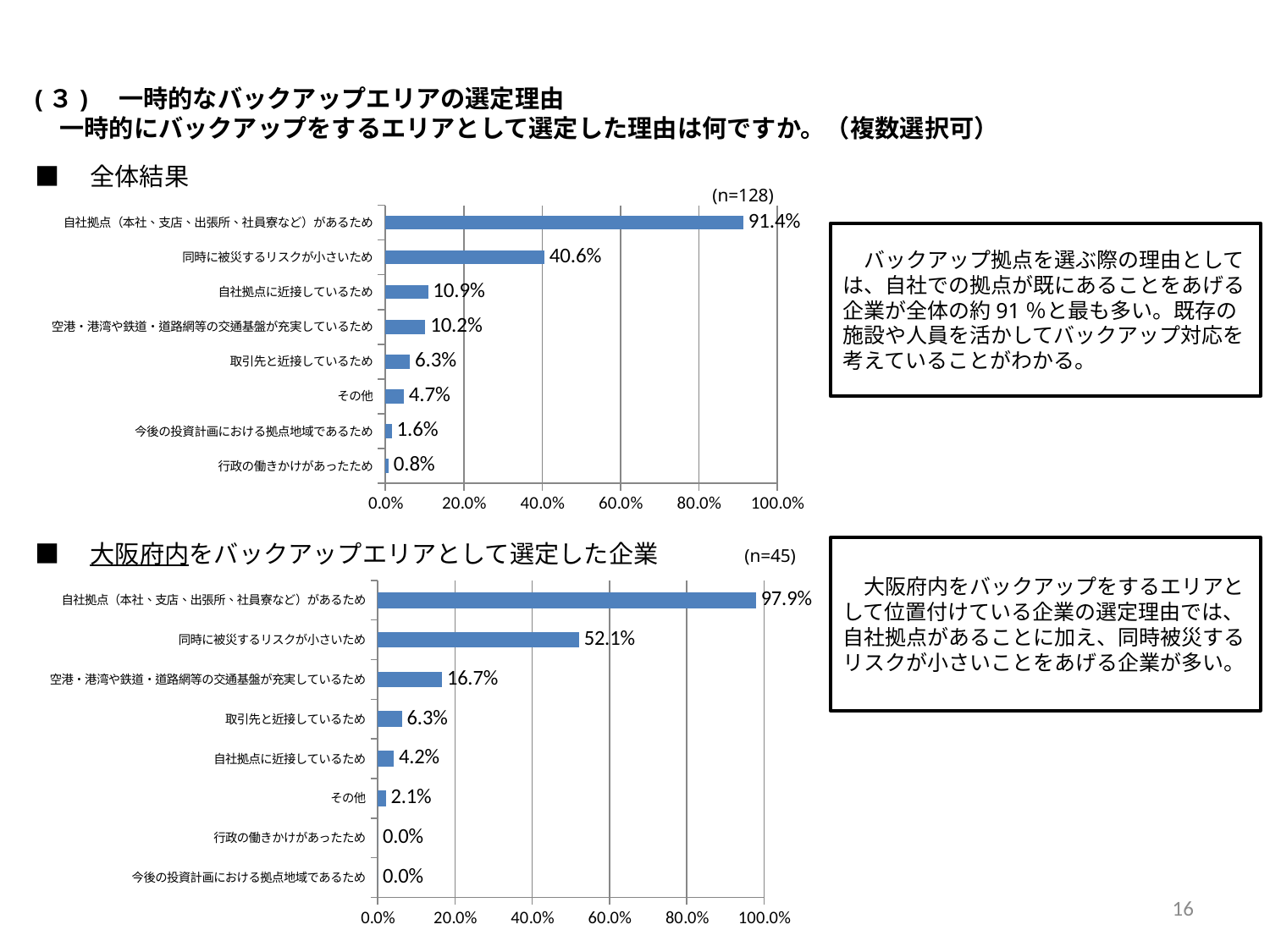
In the top chart (全体結果), which category has the highest value? 自社拠点（本社、支店、出張所、社員寮など）があるため In the top chart (全体結果), what is the value for 同時に被災するリスクが小さいため? 40.6% In the top chart (全体結果), which category has the lowest value? 行政の働きかけがあったため In the bottom chart (大阪府内をバックアップエリアとして選定した企業), what is the difference between 自社拠点（本社、支店、出張所、社員寮など）があるため and 同時に被災するリスクが小さいため? 45.8% In the bottom chart (大阪府内をバックアップエリアとして選定した企業), which is larger: 取引先と近接しているため or 自社拠点に近接しているため? 取引先と近接しているため In the top chart (全体結果), what is the difference between 自社拠点に近接しているため and 空港・港湾や鉄道・道路網等の交通基盤が充実しているため? 0.7% What type of chart is the top chart (全体結果)? Bar chart In the bottom chart (大阪府内をバックアップエリアとして選定した企業), what is the value for 空港・港湾や鉄道・道路網等の交通基盤が充実しているため? 16.7% In the bottom chart (大阪府内をバックアップエリアとして選定した企業), how many categories have a value of 0.0%? 2 In the bottom chart (大阪府内をバックアップエリアとして選定した企業), what is the value for 自社拠点（本社、支店、出張所、社員寮など）があるため? 97.9% In the top chart (全体結果), what is the sample size shown? n=128 In the top chart (全体結果), how many categories are shown? 8